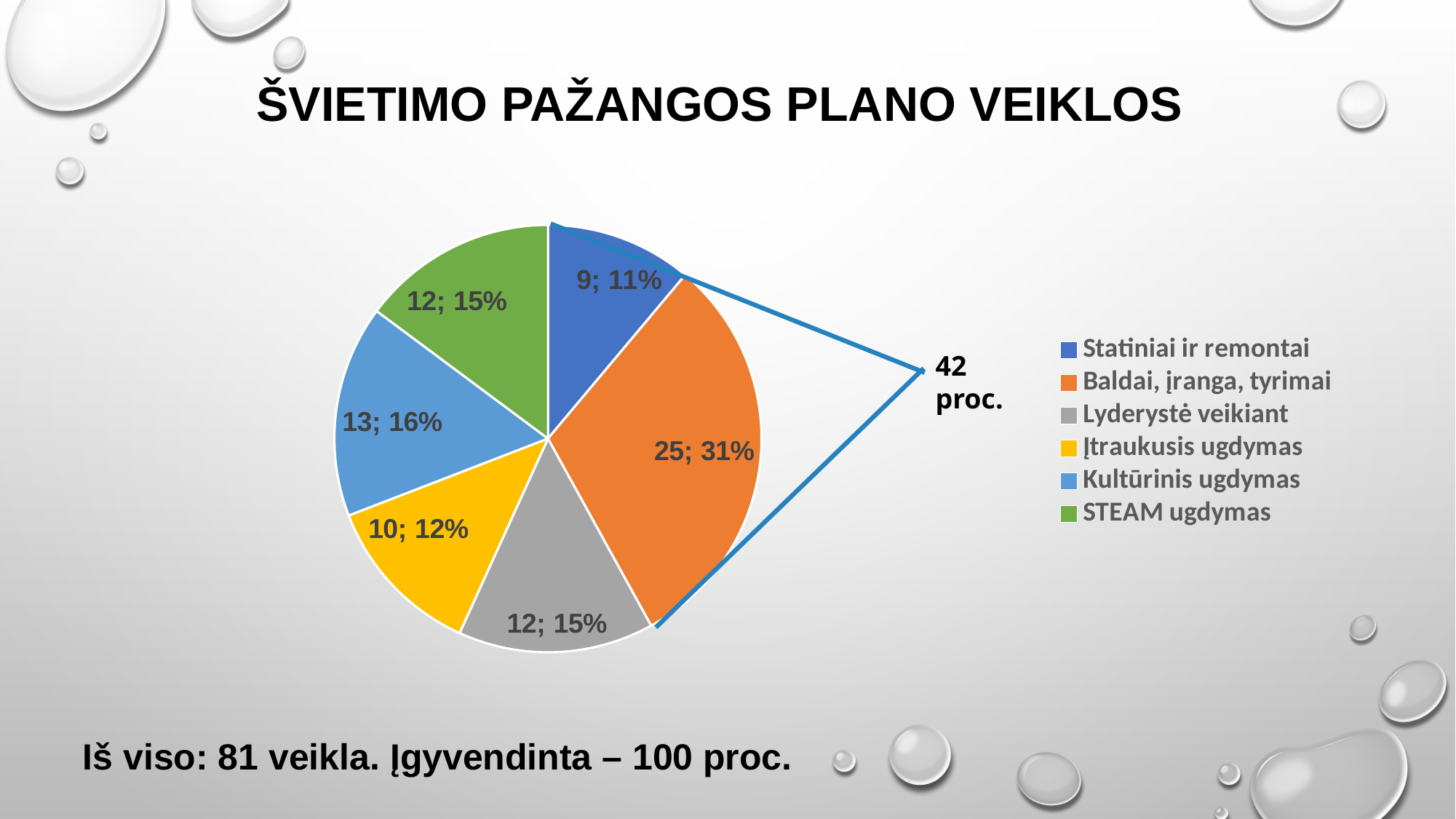
What value is shown for Baldai, įranga, tyrimai? 25 What colour is the slice for STEAM ugdymas? green Which is larger, the value for Kultūrinis ugdymas or the value for Įtraukusis ugdymas? Kultūrinis ugdymas What value is shown for Kultūrinis ugdymas? 13 Which category has the smallest slice in the pie chart? Statiniai ir remontai What percentage share does Įtraukusis ugdymas have? 12% How many slices does the pie chart have? 6 What is the title of the slide containing the pie chart? ŠVIETIMO PAŽANGOS PLANO VEIKLOS What percentage share does Statiniai ir remontai have in the pie chart? 11% Which category has the largest slice in the pie chart? Baldai, įranga, tyrimai What is the difference between the values for Baldai, įranga, tyrimai and Kultūrinis ugdymas? 12 What kind of chart is shown on the slide? pie chart